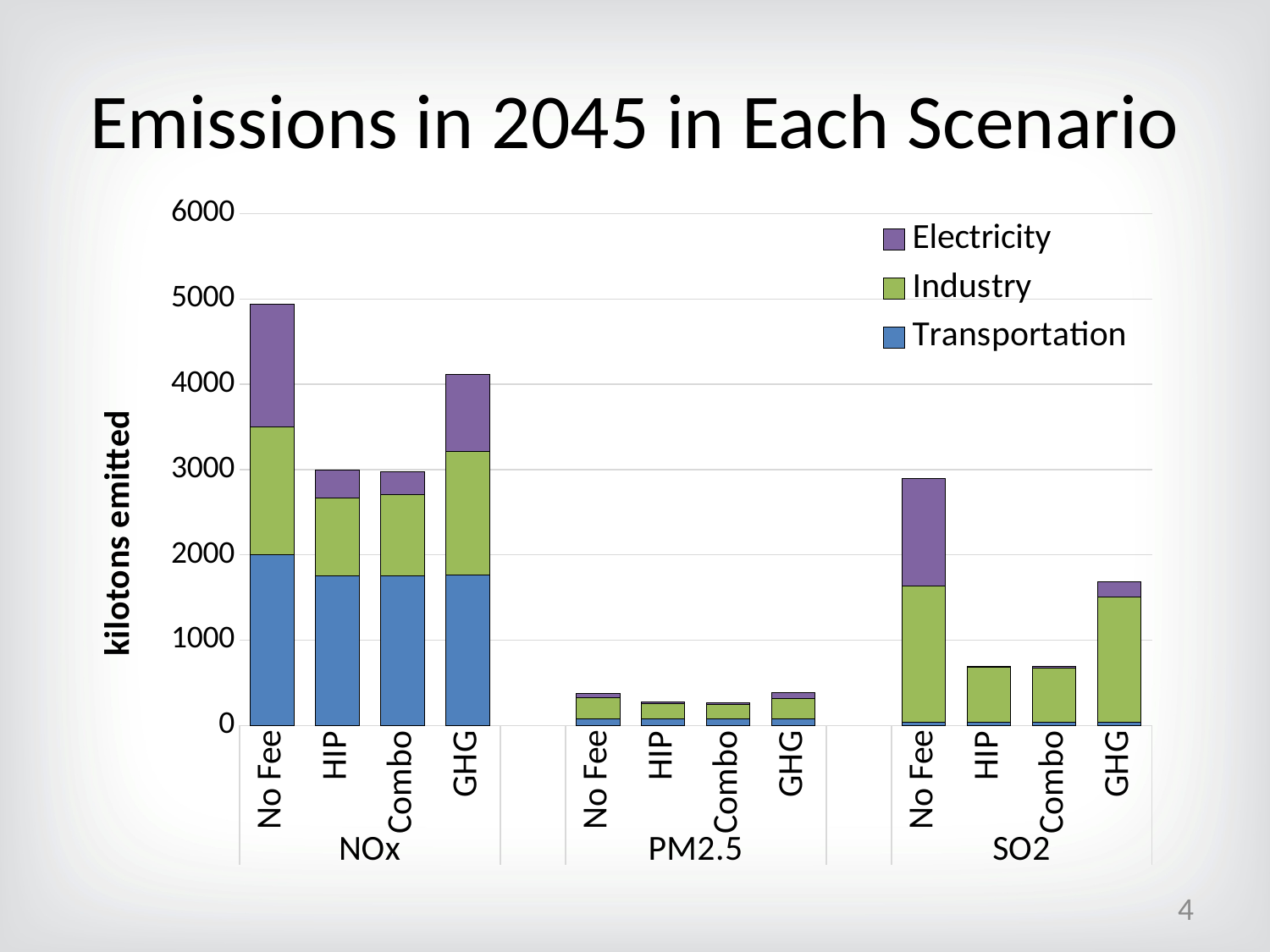
How many bars are plotted in the chart in total? 12 Is the total for HIP in the SO2 group greater or less than 1000? less What is the label on the vertical axis? kilotons emitted Is the total for No Fee in the NOx group greater or less than 4000? greater Is the total for GHG in the NOx group greater or less than 3000? greater How many series does the legend list? 3 Which bar has the highest total emissions in the chart? No Fee (NOx) Within the SO2 group, which scenario has the highest total emissions? No Fee What kind of chart is shown on the slide? Stacked bar chart Which is larger: the total for GHG in the NOx group or the total for No Fee in the SO2 group? GHG in the NOx group Which series is shown in purple according to the legend? Electricity